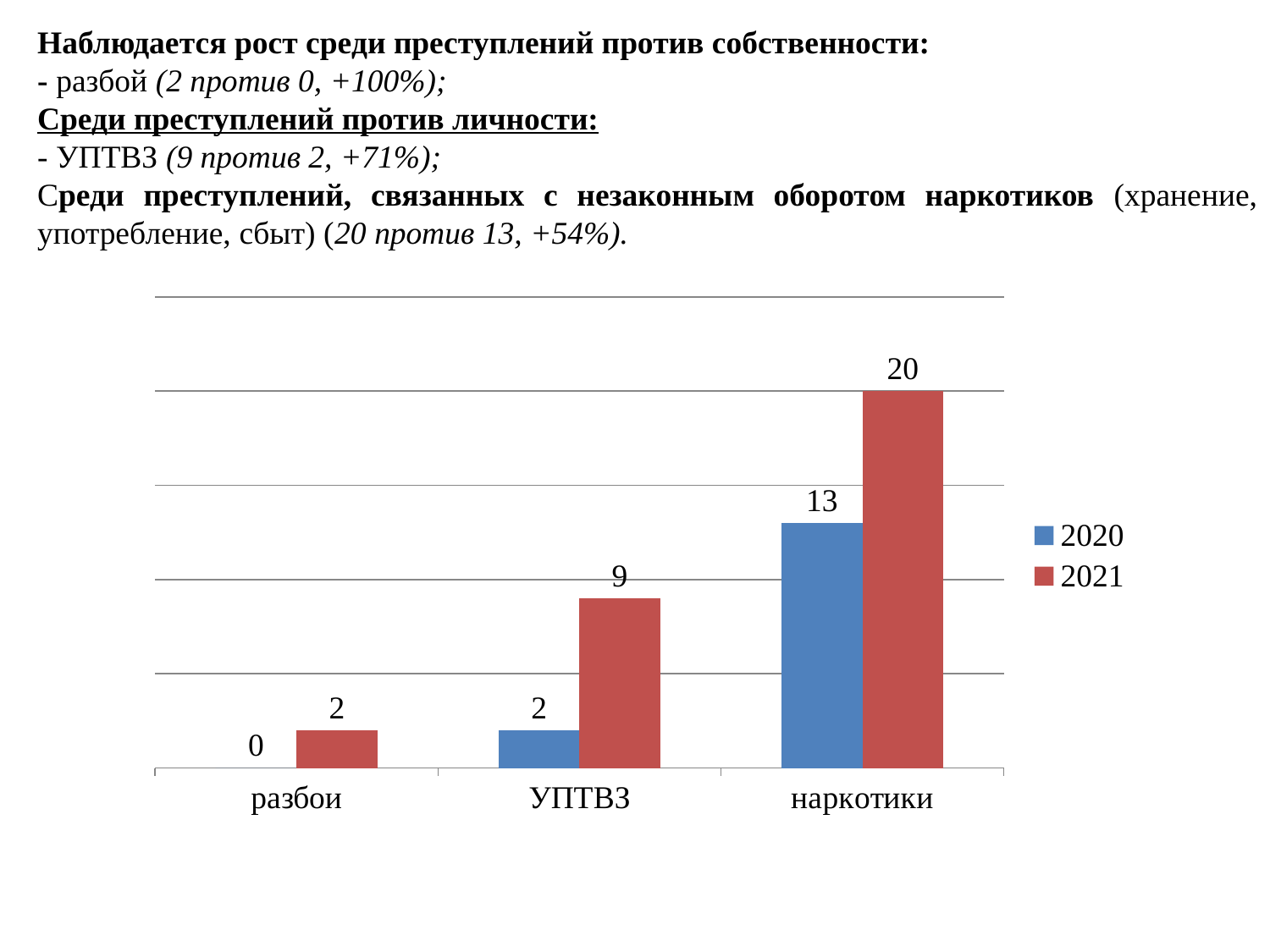
What is the value for наркотики in 2021? 20 Which category has the lowest value in 2020? разбои What is the difference between the 2021 and 2020 values for наркотики? 7 How many series does the legend list? 2 What is the value for наркотики in 2020? 13 Which is larger: the 2021 value for УПТВЗ or the 2020 value for наркотики? the 2020 value for наркотики What is the value for разбои in 2020? 0 What is the difference between the 2021 and 2020 values for УПТВЗ? 7 How many categories are shown on the x axis? 3 What is the value for УПТВЗ in 2020? 2 Which category has the highest value in 2021? наркотики What kind of chart is shown on the slide? bar chart